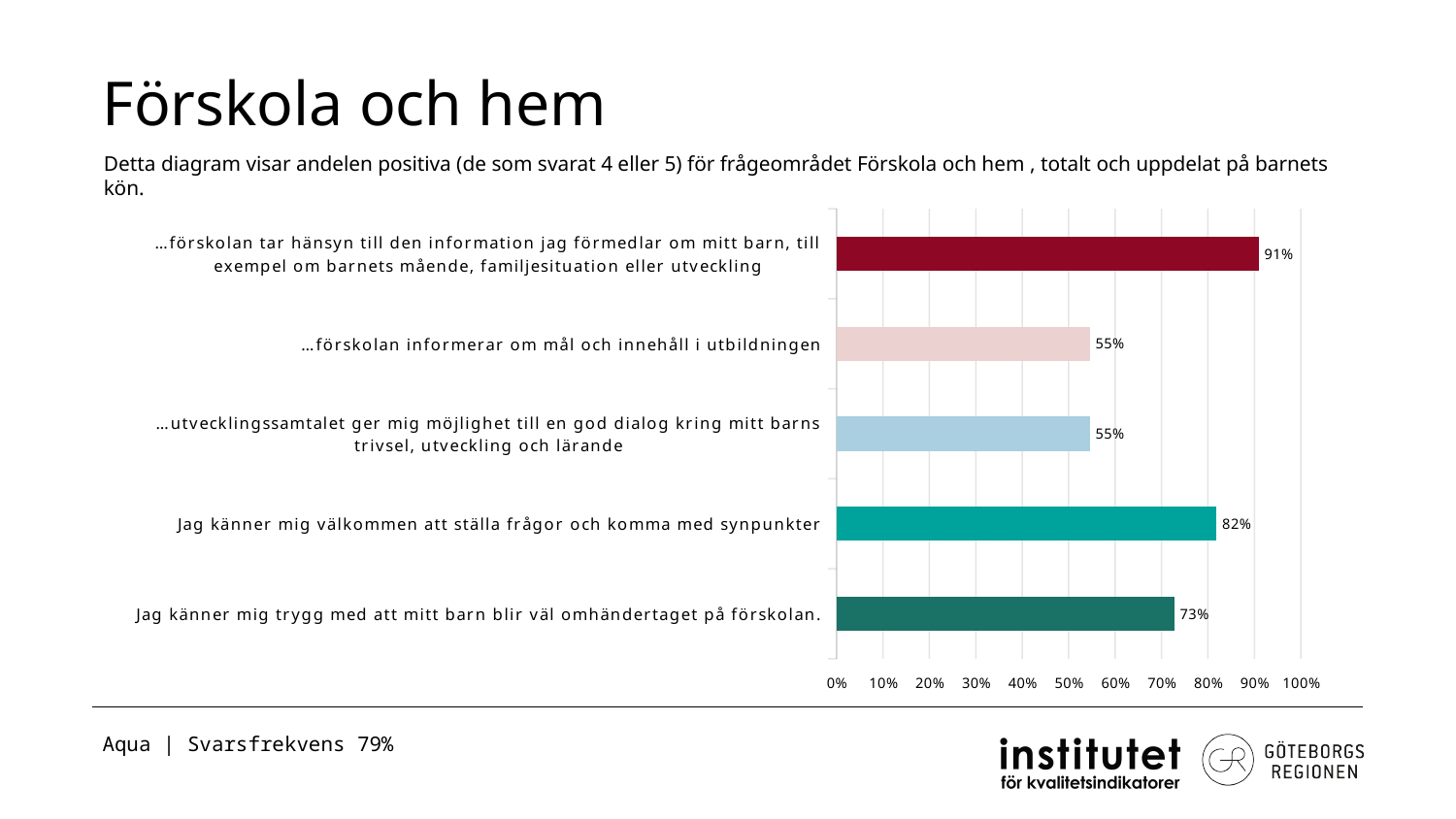
What is the highest value shown in the chart? 91% Which category has the highest value? …förskolan tar hänsyn till den information jag förmedlar om mitt barn, till exempel om barnets mående, familjesituation eller utveckling What kind of chart is shown on the slide? bar chart How many categories are shown in the chart? 5 Is the value for "…utvecklingssamtalet ger mig möjlighet till en god dialog kring mitt barns trivsel, utveckling och lärande" greater or less than 60%? less What is the difference between the value for "…förskolan tar hänsyn till den information jag förmedlar om mitt barn..." and the value for "Jag känner mig trygg med att mitt barn blir väl omhändertaget på förskolan."? 18% What is the lowest value shown in the chart? 55% Which is larger: the value for "Jag känner mig välkommen att ställa frågor och komma med synpunkter" or the value for "Jag känner mig trygg med att mitt barn blir väl omhändertaget på förskolan."? Jag känner mig välkommen att ställa frågor och komma med synpunkter What is the value for "Jag känner mig välkommen att ställa frågor och komma med synpunkter"? 82% What is the value for "…förskolan informerar om mål och innehåll i utbildningen"? 55% What is the value for "Jag känner mig trygg med att mitt barn blir väl omhändertaget på förskolan."? 73% What is the difference between the value for "Jag känner mig välkommen att ställa frågor och komma med synpunkter" and the value for "…förskolan informerar om mål och innehåll i utbildningen"? 27%